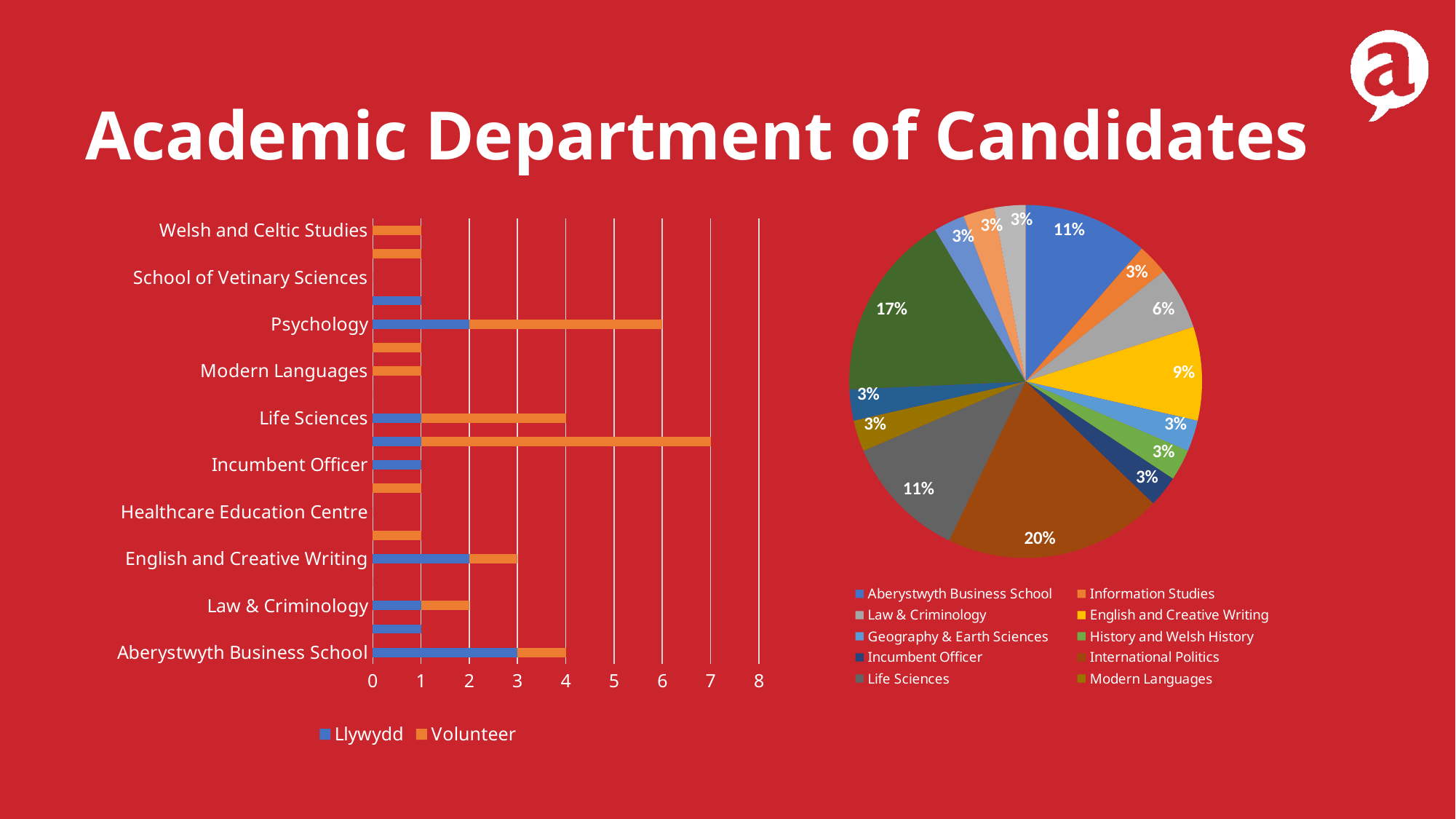
In the bar chart on the left, which has the longer total bar, Psychology or English and Creative Writing? Psychology In the bar chart on the left, what is the total of the stacked bar for Psychology? 6 In the pie chart on the right, which department has the largest slice? International Politics In the bar chart on the left, what is the Llywydd value for English and Creative Writing? 2 In the pie chart on the right, what share does English and Creative Writing have? 9% What kind of chart is the chart on the left of the slide? bar chart In the bar chart on the left, what is the total of the stacked bar for Life Sciences? 4 In the bar chart on the left, how many series does the legend list? 2 In the bar chart on the left, what is the Llywydd value for Aberystwyth Business School? 3 In the bar chart on the left, what is the Volunteer value for Psychology? 4 What kind of chart is the chart on the right of the slide? pie chart In the pie chart on the right, what share does Aberystwyth Business School have? 11%